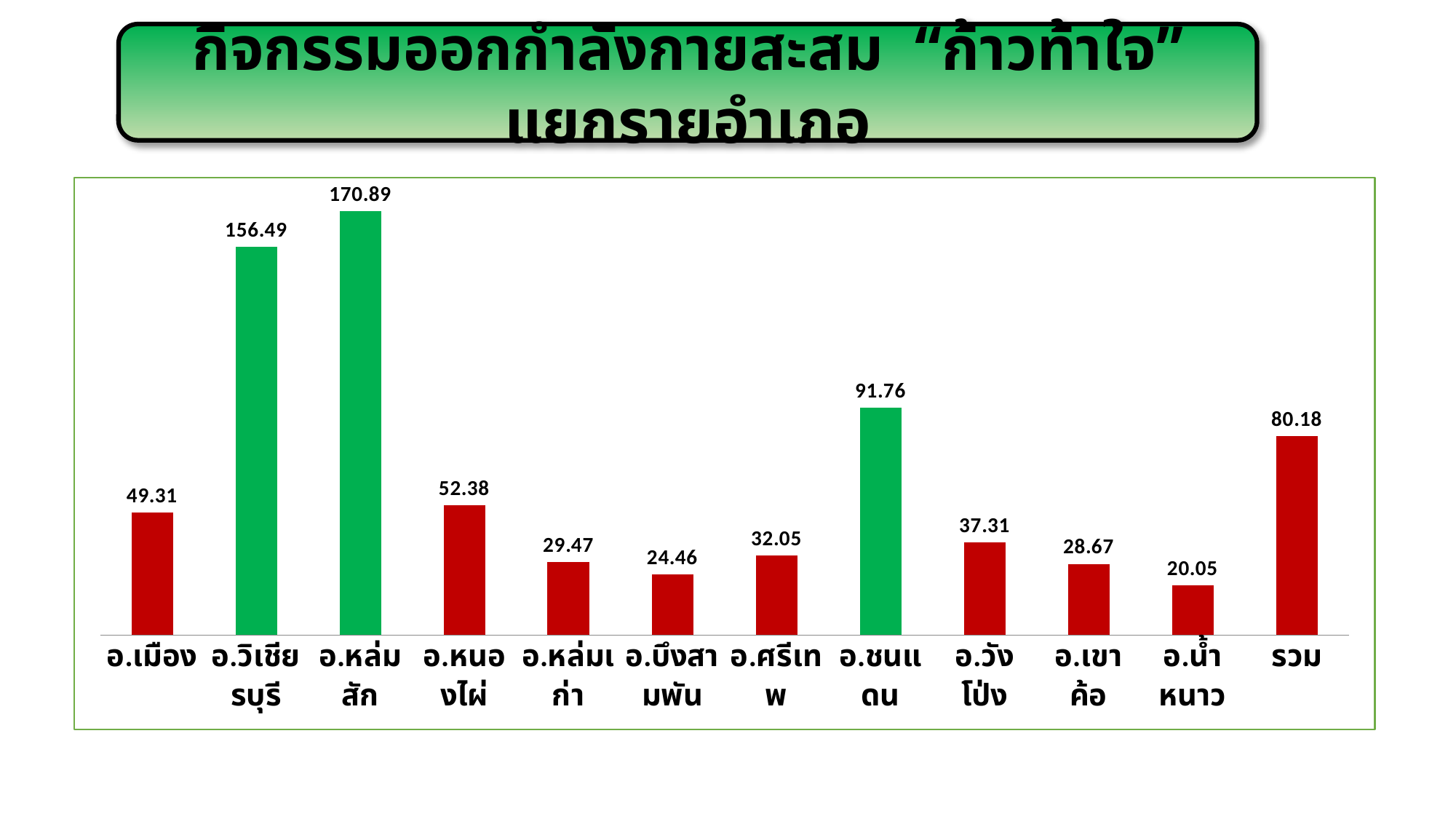
How many categories are shown on the x axis? 12 Which category has the highest value? อ.หล่มสัก What is the value for อ.ชนแดน? 91.76 What kind of chart is shown on the slide? Bar chart What is the value shown for รวม? 80.18 Which is larger, the value for อ.หนองไผ่ or the value for อ.เมือง? อ.หนองไผ่ What is the value for อ.หล่มสัก? 170.89 What colour is the bar for อ.ชนแดน? Green Which category has the lowest value? อ.น้ำหนาว What is the difference between the values for อ.ศรีเทพ and อ.บึงสามพัน? 7.59 What is the difference between the values for อ.หล่มสัก and อ.วิเชียรบุรี? 14.40 How many bars are coloured green? 3